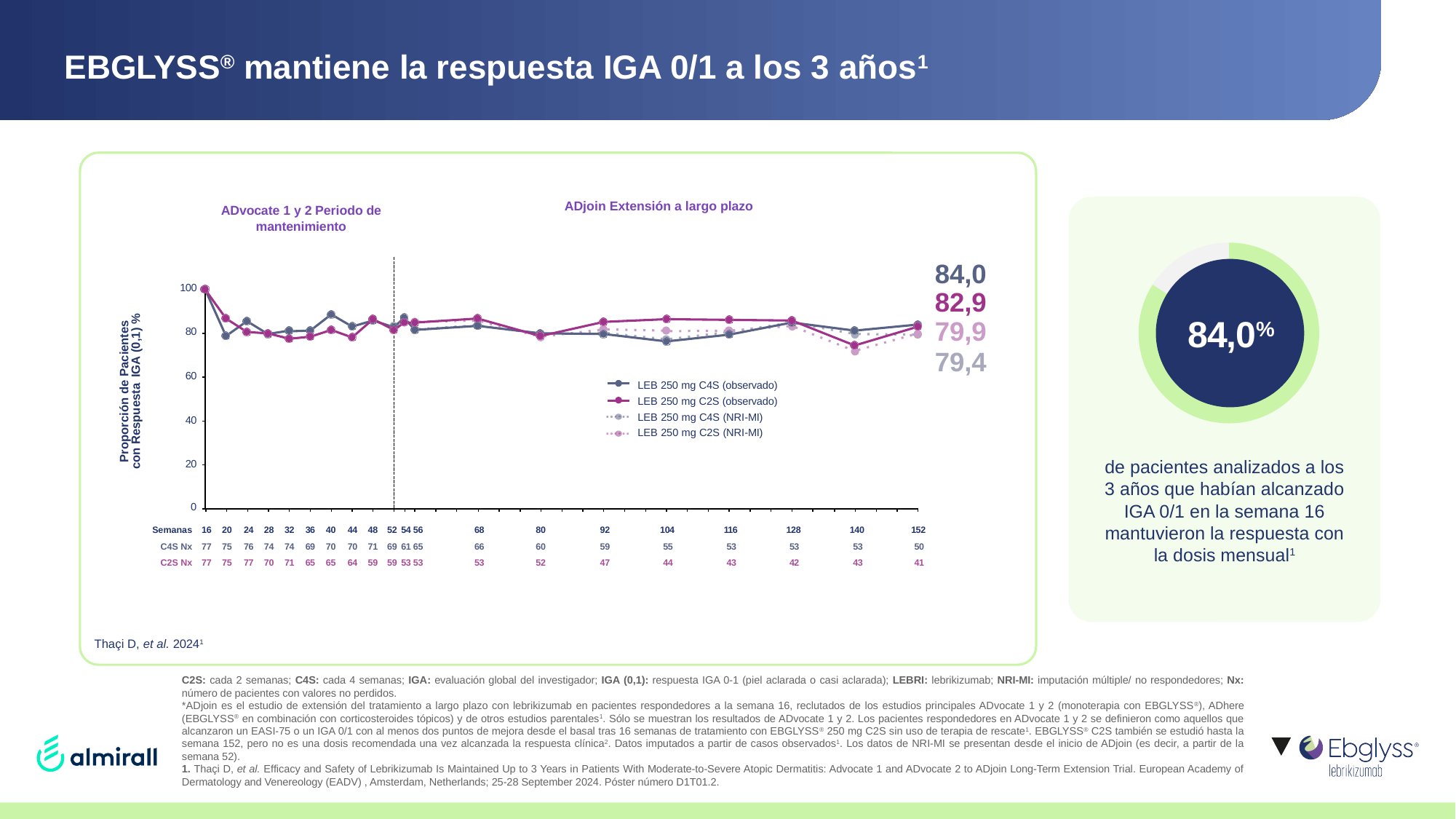
In the line chart, what is the value for LEB 250 mg C4S (observado) at week 152? 84,0 In the line chart, what is the label of the y axis? Proporción de Pacientes con Respuesta IGA (0,1) % In the line chart, what is the value for LEB 250 mg C4S (NRI-MI) at week 152? 79,9 In the line chart, what is the value for LEB 250 mg C2S (NRI-MI) at week 152? 79,4 In the line chart, which series has the highest value at week 152? LEB 250 mg C4S (observado) In the donut chart on the right, what percentage is shown in the centre? 84,0% What kind of chart is the main chart on the left of the slide? line chart In the line chart, what is the difference between the week 152 values of LEB 250 mg C4S (observado) and LEB 250 mg C2S (observado)? 1,1 In the line chart, which series has the lowest value at week 152? LEB 250 mg C2S (NRI-MI) In the line chart, what is the value for LEB 250 mg C2S (observado) at week 152? 82,9 In the line chart, how many series does the legend list? 4 In the line chart, is the value for LEB 250 mg C2S (observado) at week 16 greater or less than 80? greater